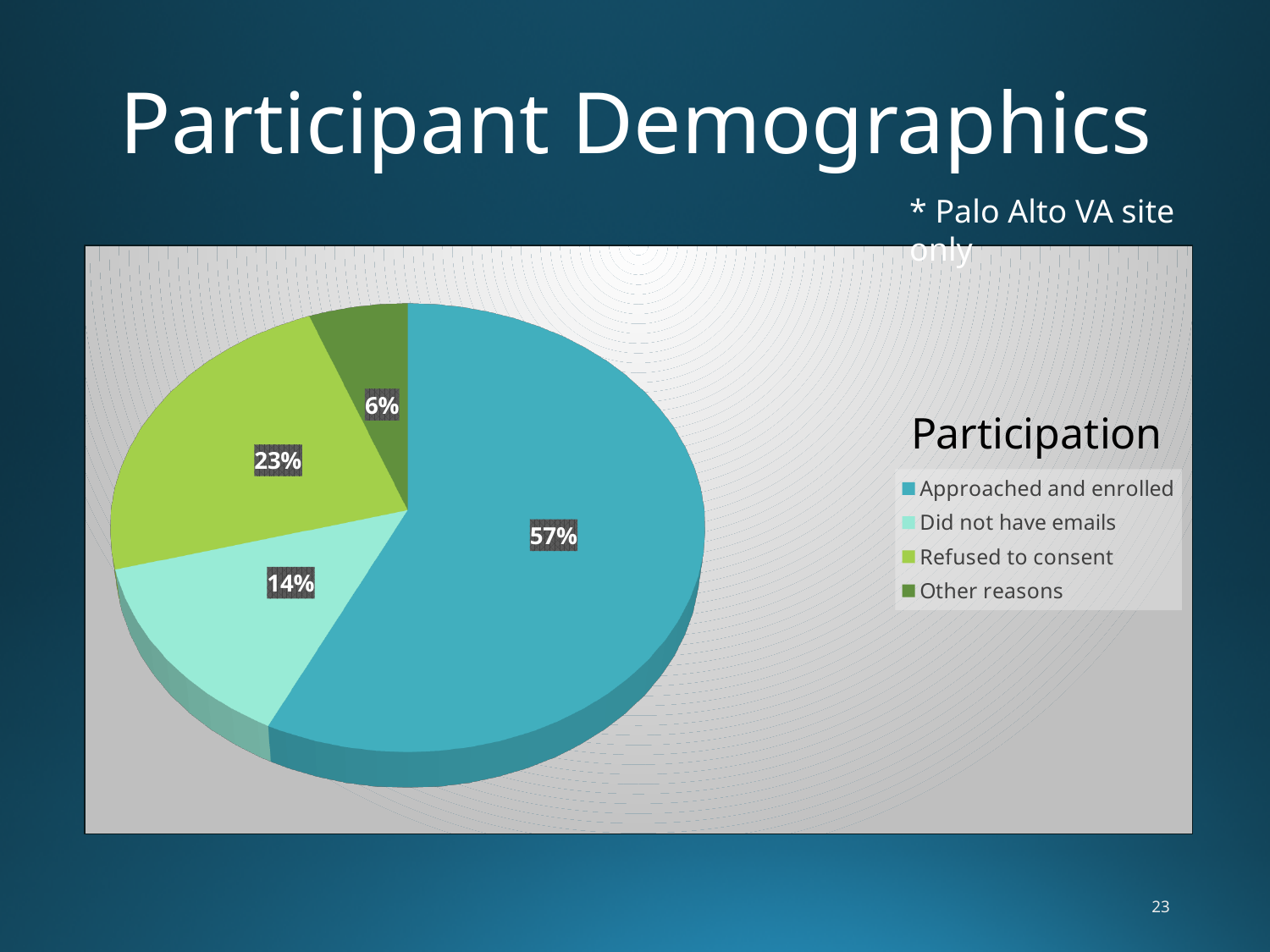
What kind of chart is shown on the slide? pie chart What share of the pie is 'Approached and enrolled'? 57% Which is larger: 'Refused to consent' or 'Did not have emails'? Refused to consent Which category has the largest slice of the pie? Approached and enrolled What share of the pie is 'Did not have emails'? 14% What is the chart's title? Participation How many categories does the pie chart show? 4 What share of the pie is 'Other reasons'? 6% What is the difference in percentage points between 'Refused to consent' and 'Did not have emails'? 9% Which legend entry is shown in the darkest green colour? Other reasons Which category has the smallest slice of the pie? Other reasons